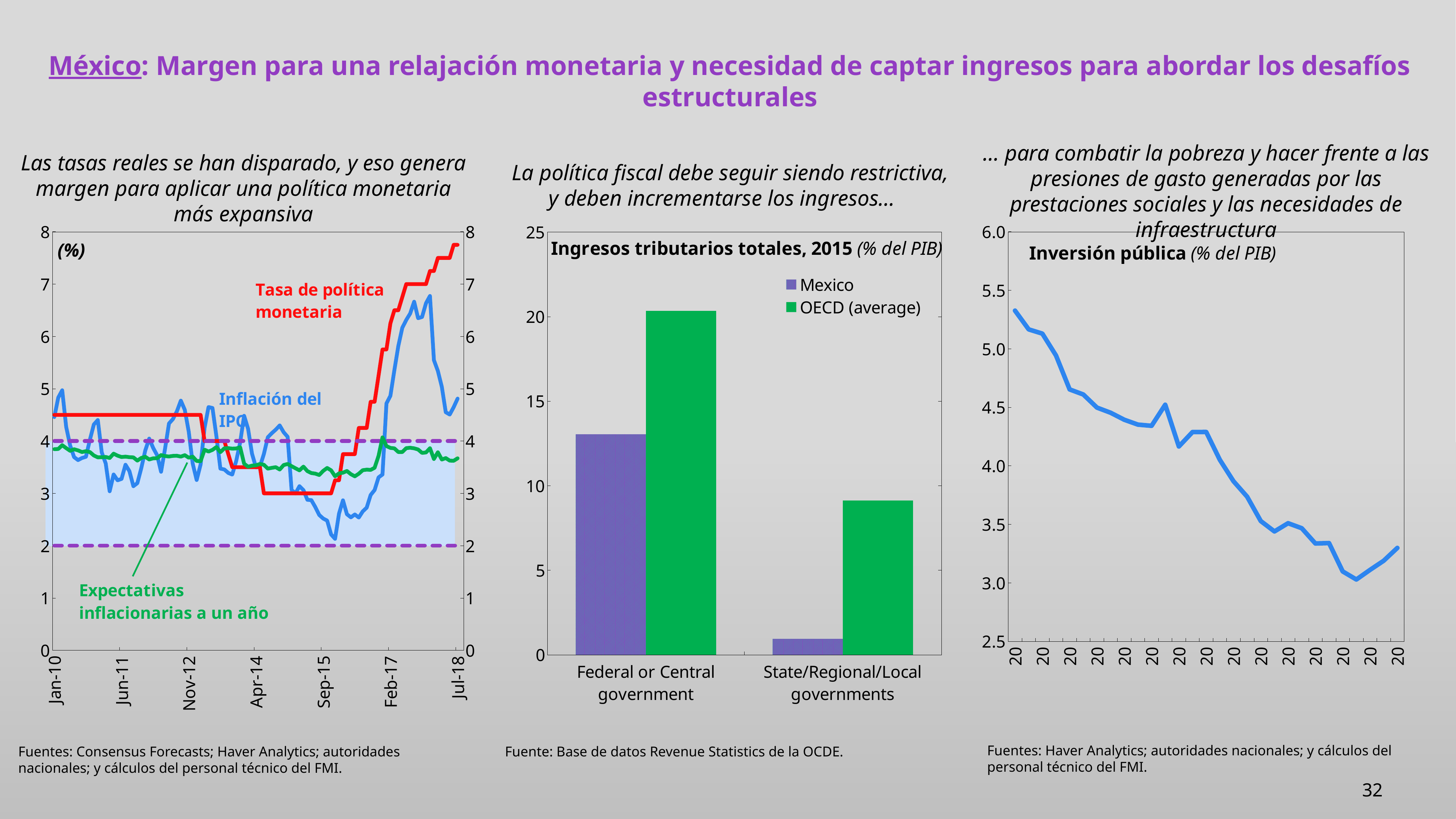
In the middle chart "Ingresos tributarios totales, 2015", how many series does the legend list? 2 In the left-hand chart, how many labelled line series are plotted? 3 What kind of chart is the right-hand chart titled "Inversión pública"? line chart In the middle chart "Ingresos tributarios totales, 2015", which is larger for Federal or Central government: Mexico or OECD (average)? OECD (average) What kind of chart is the middle chart titled "Ingresos tributarios totales, 2015"? bar chart In the middle chart "Ingresos tributarios totales, 2015", is the Mexico value for State/Regional/Local governments greater or less than 5? less In the left-hand chart, is the value of Tasa de política monetaria at Jul-18 greater or less than 7? greater In the middle chart "Ingresos tributarios totales, 2015", is the OECD (average) value for State/Regional/Local governments greater or less than 5? greater In the middle chart "Ingresos tributarios totales, 2015", how many categories are shown on the x axis? 2 In the right-hand chart "Inversión pública", do the values generally rise or fall along the x axis? fall